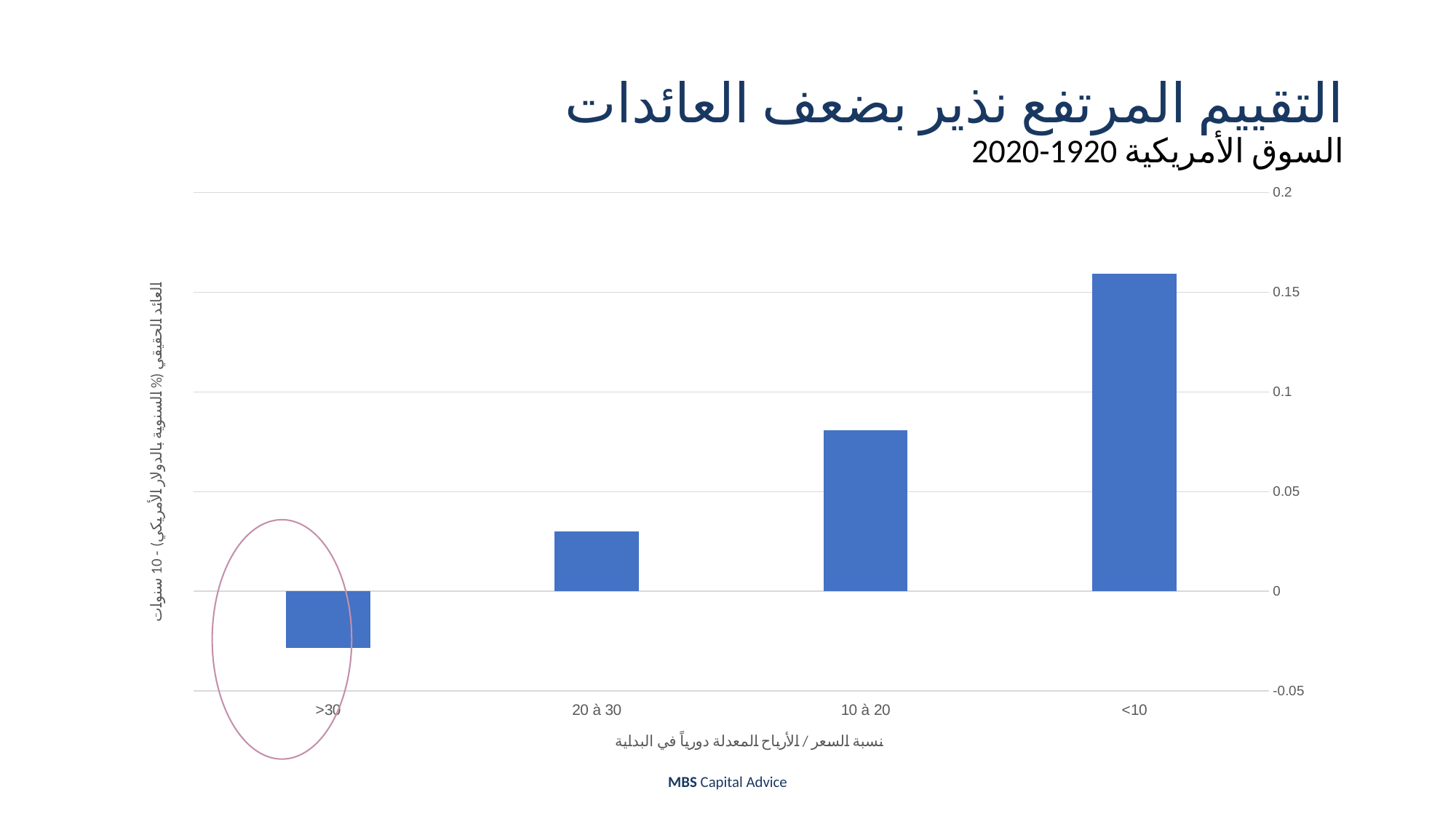
Do the bar values rise or fall moving from left to right along the x axis? rise Is the value for the category >30 greater or less than 0? less Which category has the lowest value in the chart? >30 Which category has the highest value in the chart? <10 Which category's bar is circled on the chart? >30 Is the value for the category 20 à 30 greater or less than 0.05? less Which has the larger value, the category 10 à 20 or the category 20 à 30? 10 à 20 Is the value for the category 10 à 20 greater or less than 0.05? greater How many categories are shown on the x axis of the chart? 4 What kind of chart is shown on the slide? bar chart What period does the subtitle of the slide refer to? 1920-2020